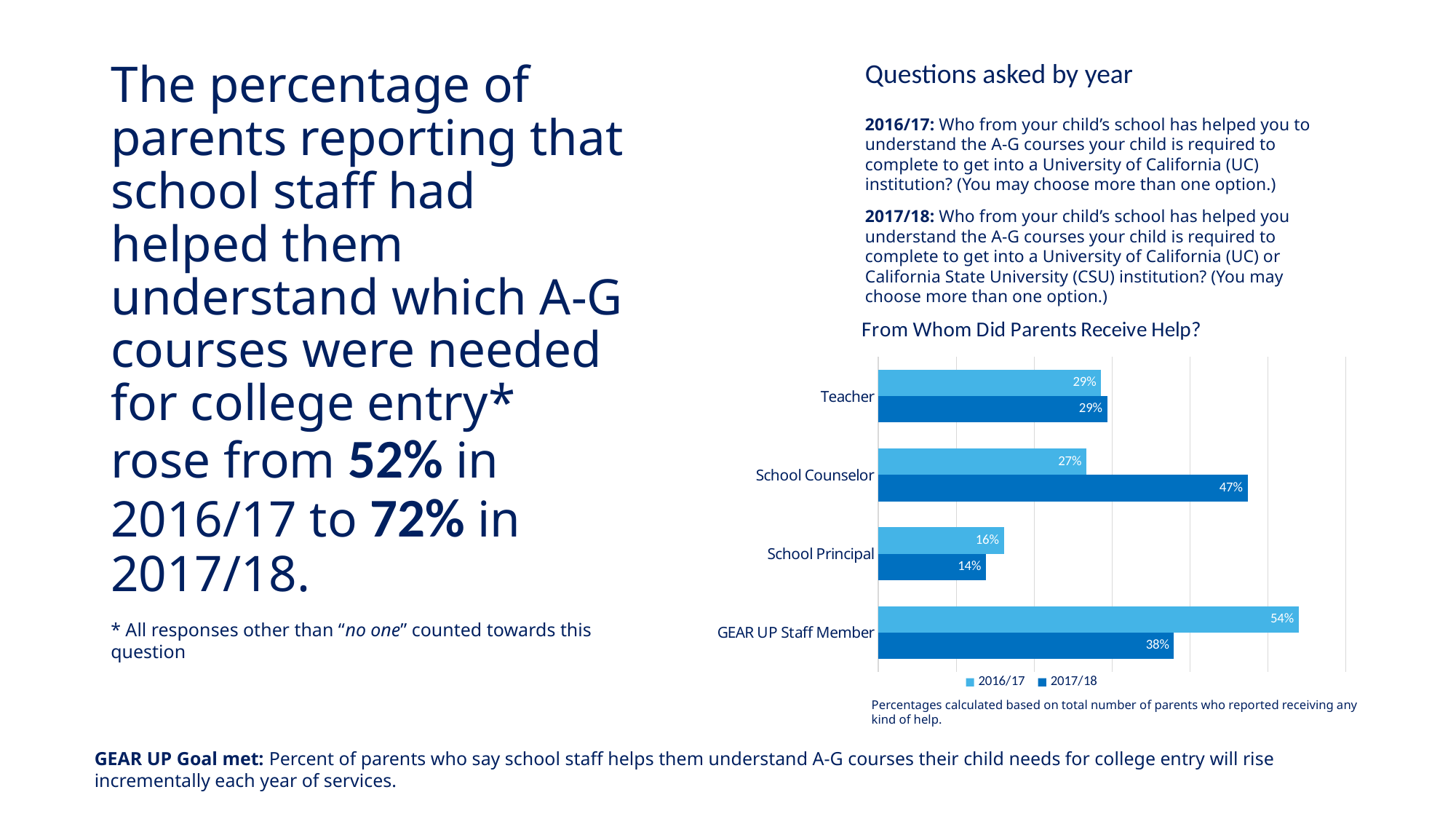
What is the difference between the 2016/17 and 2017/18 values for GEAR UP Staff Member? 16% What percentage of parents reported receiving help from a School Principal in 2017/18? 14% What percentage of parents reported receiving help from a School Counselor in 2017/18? 47% Which is larger for School Counselor: the 2016/17 value or the 2017/18 value? 2017/18 Which category has the highest value for 2016/17? GEAR UP Staff Member How many categories are shown in the chart? 4 What kind of chart is shown on the slide? Bar chart What percentage of parents reported receiving help from a GEAR UP Staff Member in 2016/17? 54% What is the title of the chart? From Whom Did Parents Receive Help? How many series does the legend list? 2 Which category has the lowest value for 2017/18? School Principal What is the difference between the 2016/17 and 2017/18 values for School Counselor? 20%